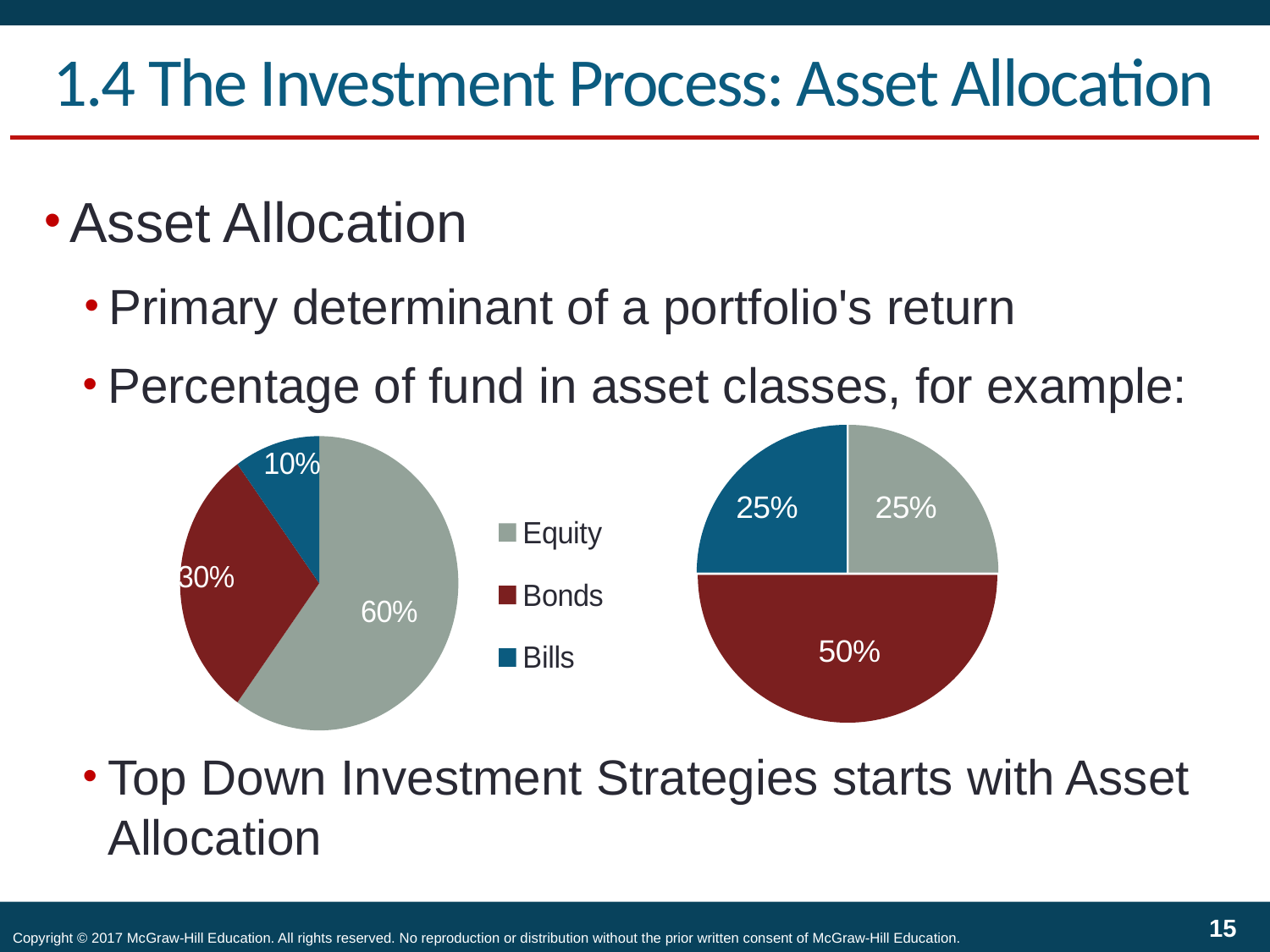
In the right pie chart, what share of the fund is in Bonds? 50% What kind of charts are shown on the slide? Pie charts In the right pie chart, what share of the fund is in Equity? 25% In the right pie chart, which asset class has the largest share? Bonds In the left pie chart, what share of the fund is in Equity? 60% In the left pie chart, what is the difference between the Equity share and the Bonds share? 30% In the left pie chart, which asset class has the smallest share? Bills In the left pie chart, what share of the fund is in Bills? 10% In the left pie chart, what share of the fund is in Bonds? 30% In the right pie chart, is the Bonds share larger or smaller than the Bills share? larger How many asset classes does the legend list? 3 In the left pie chart, which asset class has the largest share? Equity